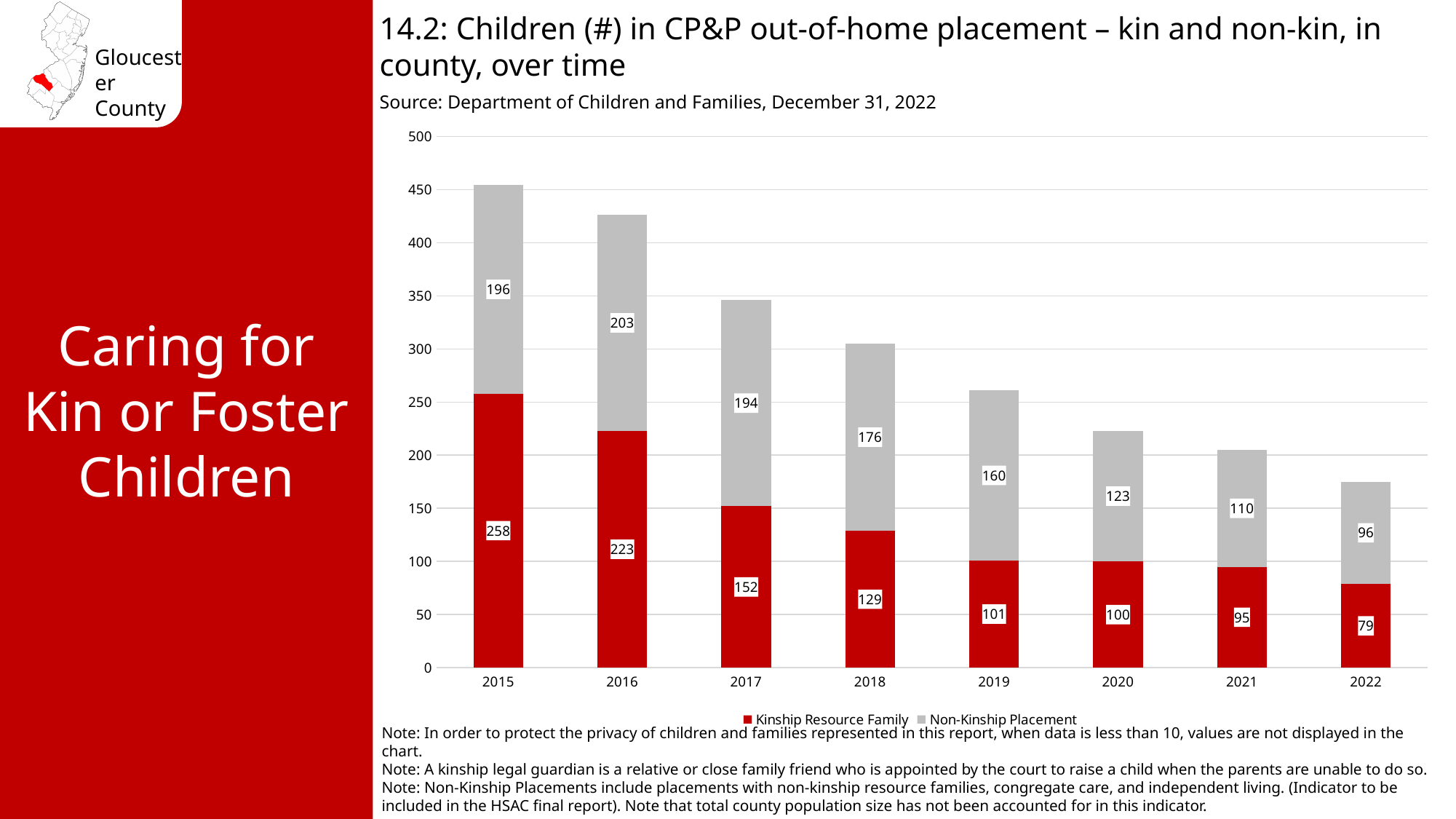
How many series does the legend list? 2 Which year has the lowest Non-Kinship Placement value? 2022 What is the total of the stacked bar for 2020? 223 What is the total of the stacked bar for 2022? 175 How many years are shown on the x axis? 8 Which is larger in 2019: Kinship Resource Family or Non-Kinship Placement? Non-Kinship Placement What kind of chart is shown? Stacked bar chart What is the Kinship Resource Family value for 2015? 258 What is the Non-Kinship Placement value for 2018? 176 What is the difference between the Kinship Resource Family values for 2016 and 2017? 71 What is the Non-Kinship Placement value for 2022? 96 Which year has the highest Kinship Resource Family value? 2015